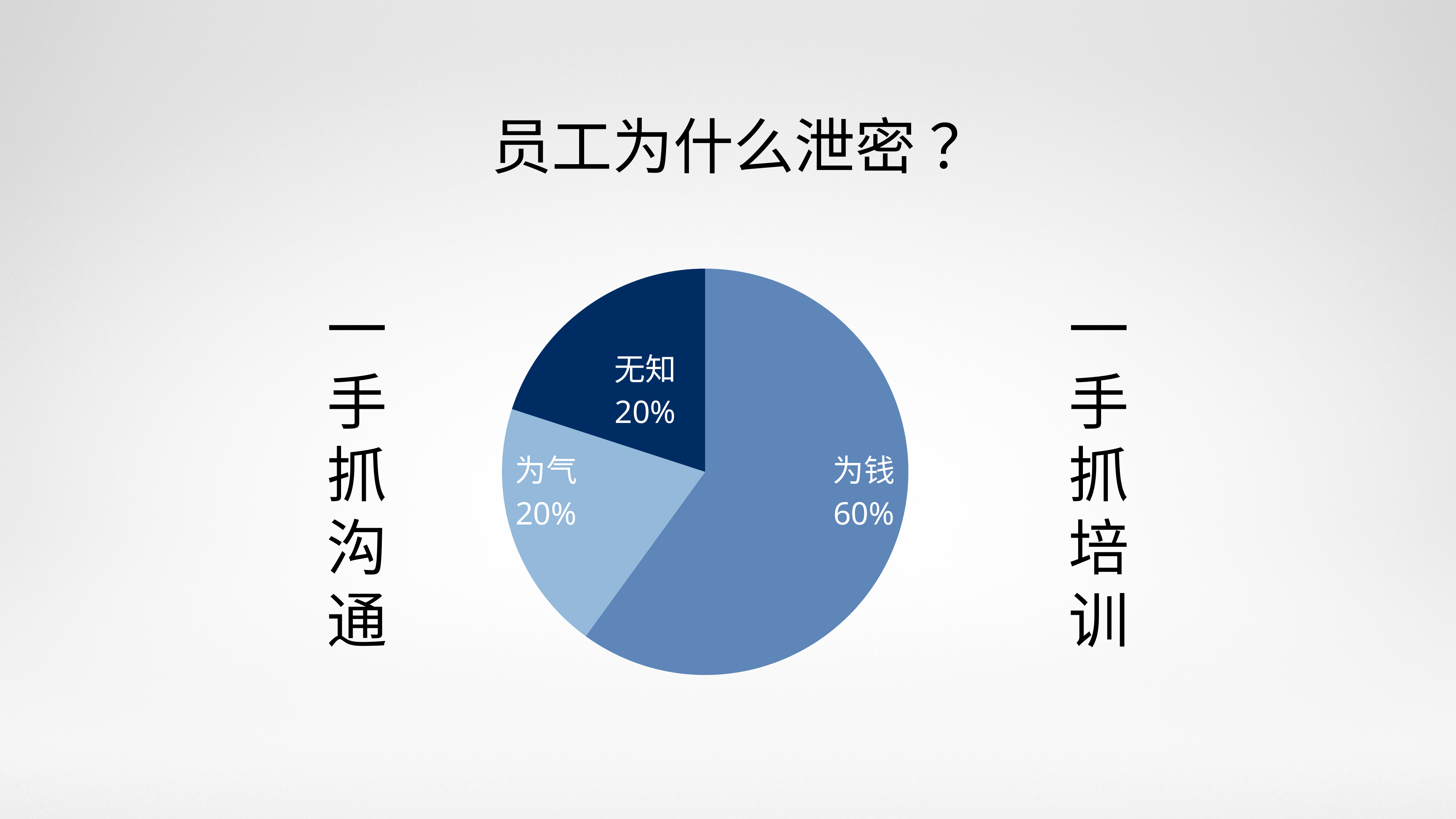
What is the difference between the share for 为钱 and the share for 无知? 40% Which slice is drawn in the darkest blue? 无知 What is the value shown for 无知? 20% What is the title of the slide above the chart? 员工为什么泄密？ What is the value shown for 为气? 20% What is the combined share of 无知 and 为气? 40% Which category has the largest slice of the pie? 为钱 How many slices does the pie chart have? 3 What share of the pie does 为钱 account for? 60% Which is larger, the slice for 为钱 or the slice for 为气? 为钱 What kind of chart is shown on the slide? pie chart